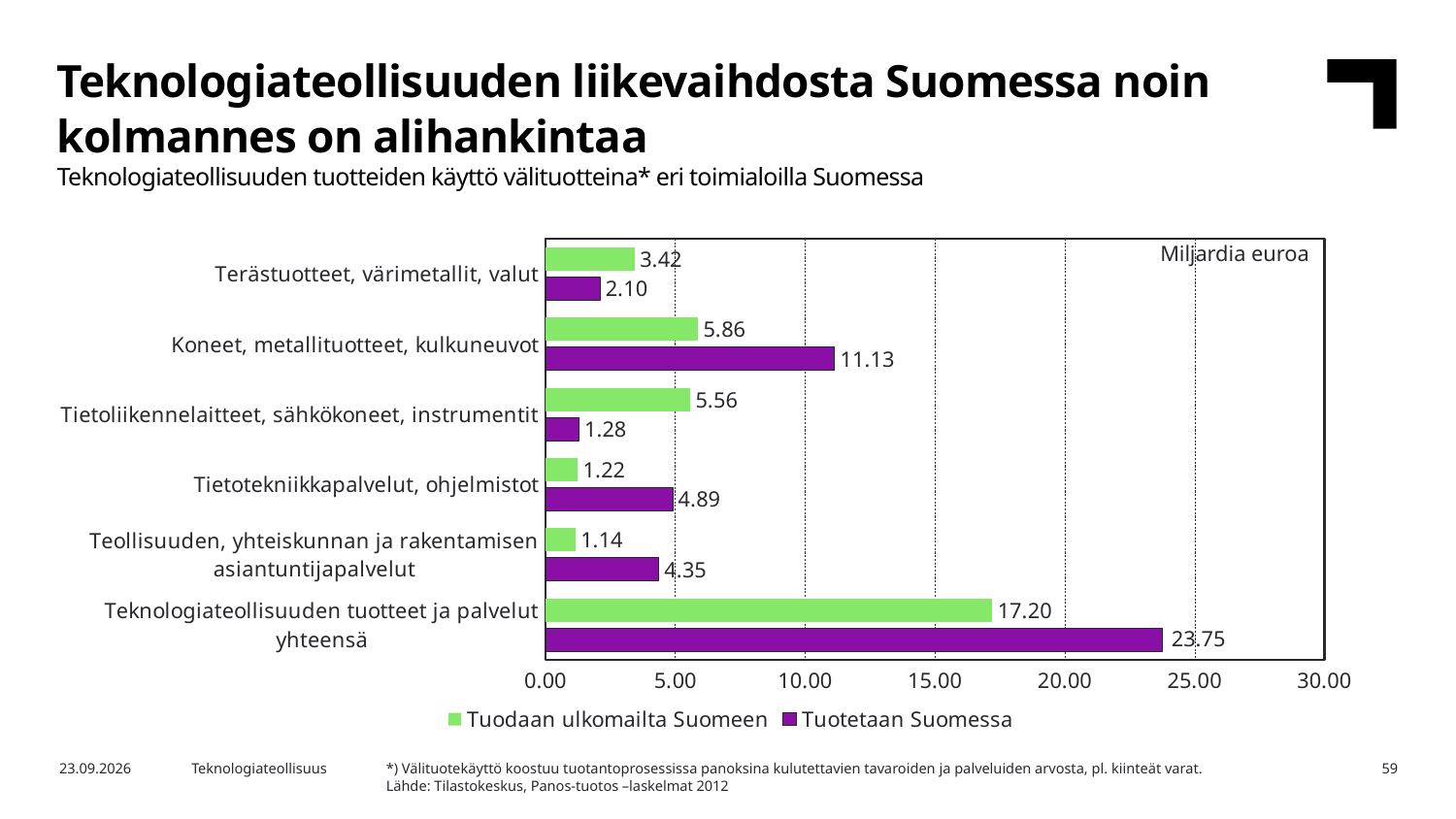
What is the value for "Tuotetaan Suomessa" in the category "Tietotekniikkapalvelut, ohjelmistot"? 4.89 Which category has the lowest value for "Tuotetaan Suomessa"? Tietoliikennelaitteet, sähkökoneet, instrumentit Which category has the highest value for "Tuodaan ulkomailta Suomeen"? Teknologiateollisuuden tuotteet ja palvelut yhteensä What is the value for "Tuotetaan Suomessa" in the category "Koneet, metallituotteet, kulkuneuvot"? 11.13 How many categories are shown on the chart? 6 For "Tietoliikennelaitteet, sähkökoneet, instrumentit", which series has the larger value: "Tuodaan ulkomailta Suomeen" or "Tuotetaan Suomessa"? Tuodaan ulkomailta Suomeen Is the value for "Tuotetaan Suomessa" in "Teknologiateollisuuden tuotteet ja palvelut yhteensä" greater or less than 20.00? greater What is the difference between "Tuotetaan Suomessa" and "Tuodaan ulkomailta Suomeen" for "Teknologiateollisuuden tuotteet ja palvelut yhteensä"? 6.55 How many series does the legend list? 2 What unit is indicated in the top right corner of the chart? Miljardia euroa What kind of chart is shown on the slide? Bar chart What is the value for "Tuodaan ulkomailta Suomeen" in the category "Terästuotteet, värimetallit, valut"? 3.42